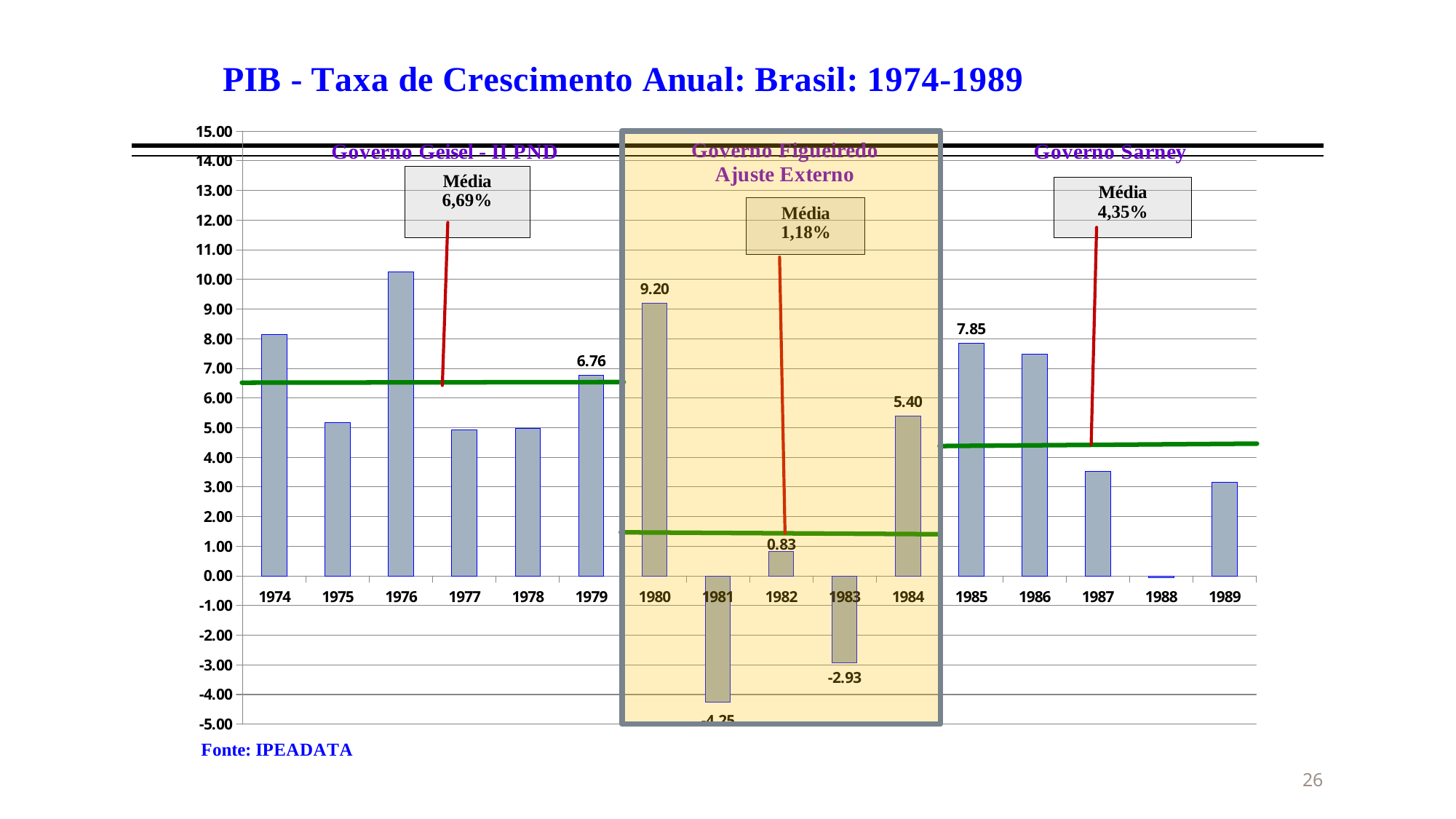
What is the value shown for 1983? -2.93 What is the GDP growth rate shown for 1980? 9.20 What is the difference between the values for 1980 and 1984? 3.80 Which year has the lowest value in the chart? 1981 Is the value for 1976 greater or less than 9.00? greater Which year has the highest value in the chart? 1976 What is the value shown for 1979? 6.76 What is the average (Média) shown for the Governo Sarney period? 4,35% Which year has the larger value, 1980 or 1985? 1980 Is the value for 1988 greater or less than 1.00? less What is the value plotted for 1985? 7.85 How many years are plotted in the chart? 16